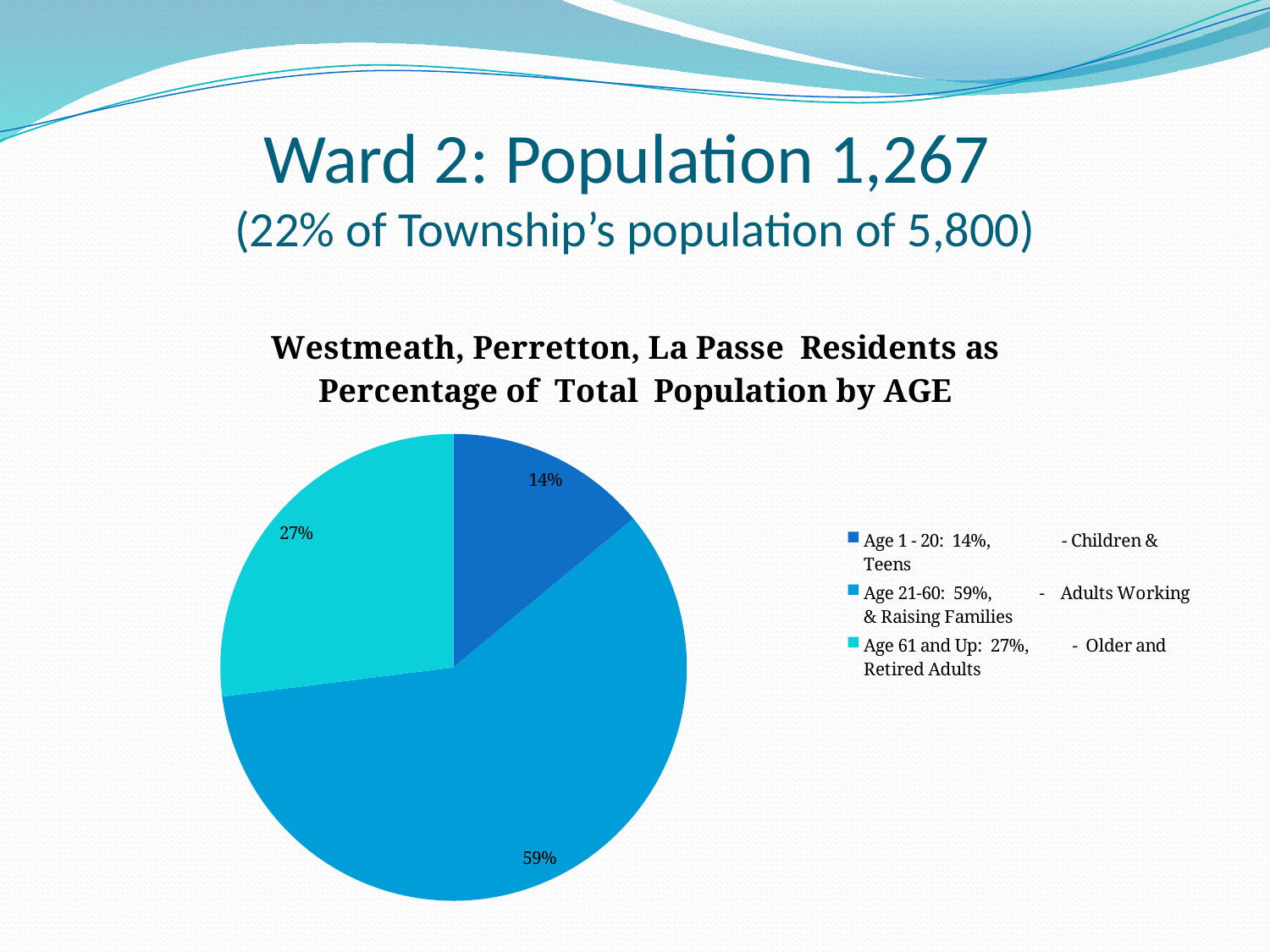
What is the title of the pie chart? Westmeath, Perretton, La Passe Residents as Percentage of Total Population by AGE Which is larger, the Age 61 and Up slice or the Age 1 - 20 slice? Age 61 and Up What percentage of the population is Age 1 - 20? 14% What percentage of the population is Age 61 and Up? 27% How many entries does the legend list? 3 Which age group has the smallest share of the pie? Age 1 - 20 What kind of chart is shown on the slide? pie chart How many slices does the pie chart have? 3 What is the difference in percentage points between the Age 21-60 slice and the Age 61 and Up slice? 32 What is the difference in percentage points between the Age 61 and Up slice and the Age 1 - 20 slice? 13 Which age group has the largest share of the pie? Age 21-60 What percentage of the population is Age 21-60? 59%